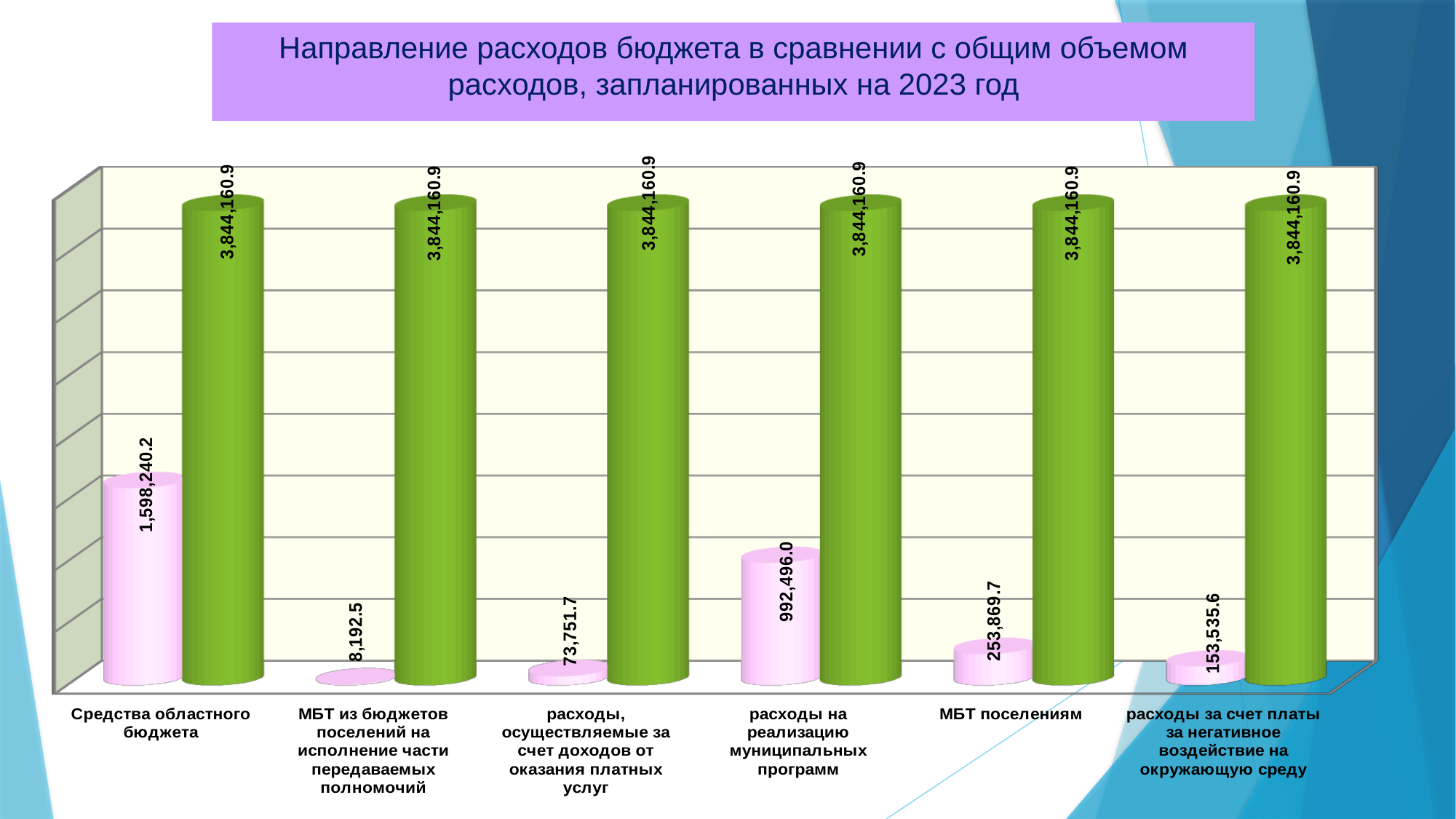
How many categories are shown on the x axis? 6 What is the pink bar value for «расходы на реализацию муниципальных программ»? 992,496.0 Which category has the lowest pink bar value? МБТ из бюджетов поселений на исполнение части передаваемых полномочий What is the difference between the green bar and the pink bar for «Средства областного бюджета»? 2,245,920.7 What is the difference between the pink bar values for «МБТ поселениям» and «расходы за счет платы за негативное воздействие на окружающую среду»? 100,334.1 What is the pink bar value for «расходы за счет платы за негативное воздействие на окружающую среду»? 153,535.6 What is the pink bar value for «МБТ поселениям»? 253,869.7 What value is shown on each green bar? 3,844,160.9 What kind of chart is shown on the slide? Bar chart Which pink bar is larger: «расходы, осуществляемые за счет доходов от оказания платных услуг» or «МБТ поселениям»? МБТ поселениям Which category has the highest pink bar value? Средства областного бюджета What is the pink bar value for «Средства областного бюджета»? 1,598,240.2